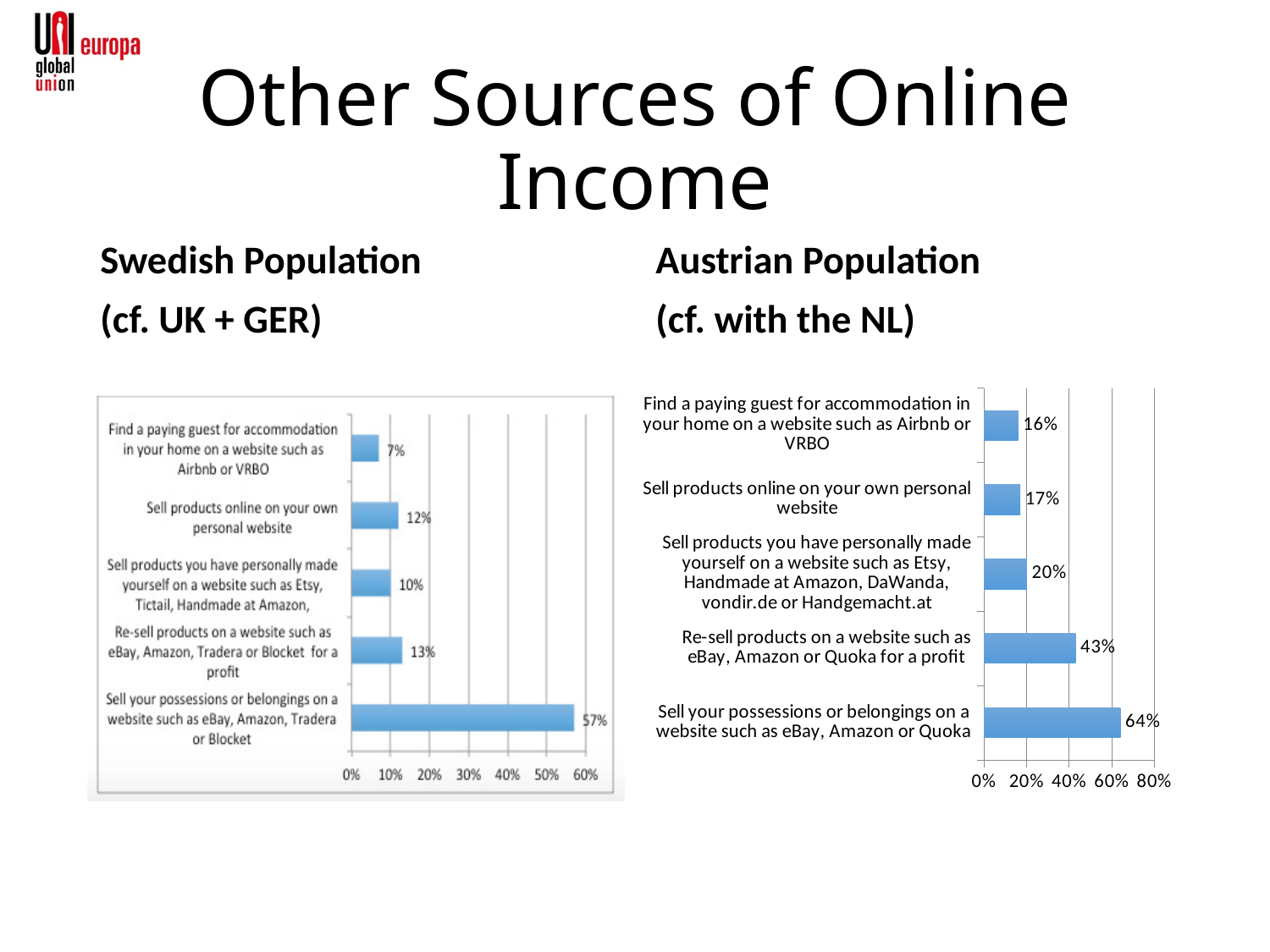
In the Austrian Population chart, what is the difference between the values for selling possessions (64%) and re-selling products for a profit (43%)? 21% In the Swedish Population chart, what is the difference between the values for 'Re-sell products on a website such as eBay, Amazon, Tradera or Blocket for a profit' and 'Sell products you have personally made yourself'? 3% In the Austrian Population chart, which category has the highest value? Sell your possessions or belongings on a website such as eBay, Amazon or Quoka In the Austrian Population chart, what is the value for 'Sell products online on your own personal website'? 17% In the Swedish Population chart, what is the value for 'Find a paying guest for accommodation in your home on a website such as Airbnb or VRBO'? 7% In the Swedish Population chart, which category has the lowest value? Find a paying guest for accommodation in your home on a website such as Airbnb or VRBO In the Swedish Population chart, what is the value for 'Sell your possessions or belongings on a website such as eBay, Amazon, Tradera or Blocket'? 57% How many categories are shown in the Austrian Population chart? 5 In the Swedish Population chart, which is larger: the value for 'Sell products online on your own personal website' or the value for 'Sell products you have personally made yourself'? Sell products online on your own personal website In the Austrian Population chart, is the value for 'Sell your possessions or belongings on a website such as eBay, Amazon or Quoka' greater or less than 60%? greater In the Austrian Population chart, what is the value for 'Re-sell products on a website such as eBay, Amazon or Quoka for a profit'? 43% What type of chart is the Swedish Population chart? Bar chart